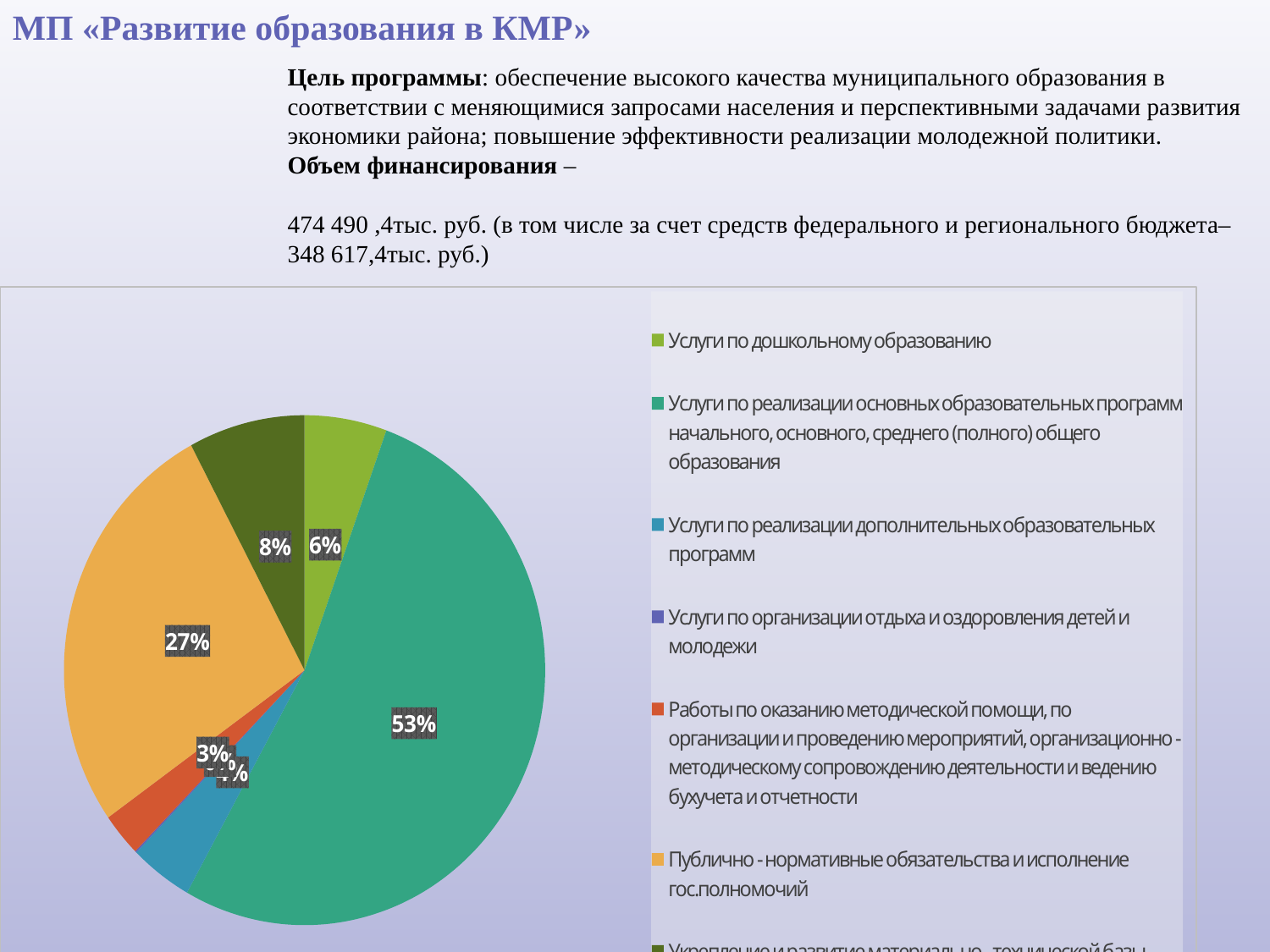
What colour is the slice for «Услуги по дошкольному образованию» in the pie chart? light green By how many percentage points does the 53% slice exceed the 27% slice? 26 What percentage is labelled on the dark green slice of the pie chart? 8% What colour is the largest slice of the pie chart? teal green What share of the pie chart is labelled for «Публично - нормативные обязательства и исполнение гос.полномочий»? 27% Which category has the largest slice in the pie chart? Услуги по реализации основных образовательных программ начального, основного, среднего (полного) общего образования By how many percentage points does the slice for «Публично - нормативные обязательства и исполнение гос.полномочий» exceed the slice for «Услуги по дошкольному образованию»? 21 What share of the pie chart is labelled for «Услуги по дошкольному образованию»? 6% Which is larger: the slice for «Услуги по дошкольному образованию» or the slice for «Публично - нормативные обязательства и исполнение гос.полномочий»? Публично - нормативные обязательства и исполнение гос.полномочий What type of chart is shown on the slide? pie chart Is the share for «Услуги по реализации основных образовательных программ начального, основного, среднего (полного) общего образования» greater or less than 50%? greater What share of the pie chart is labelled for «Услуги по реализации основных образовательных программ начального, основного, среднего (полного) общего образования»? 53%